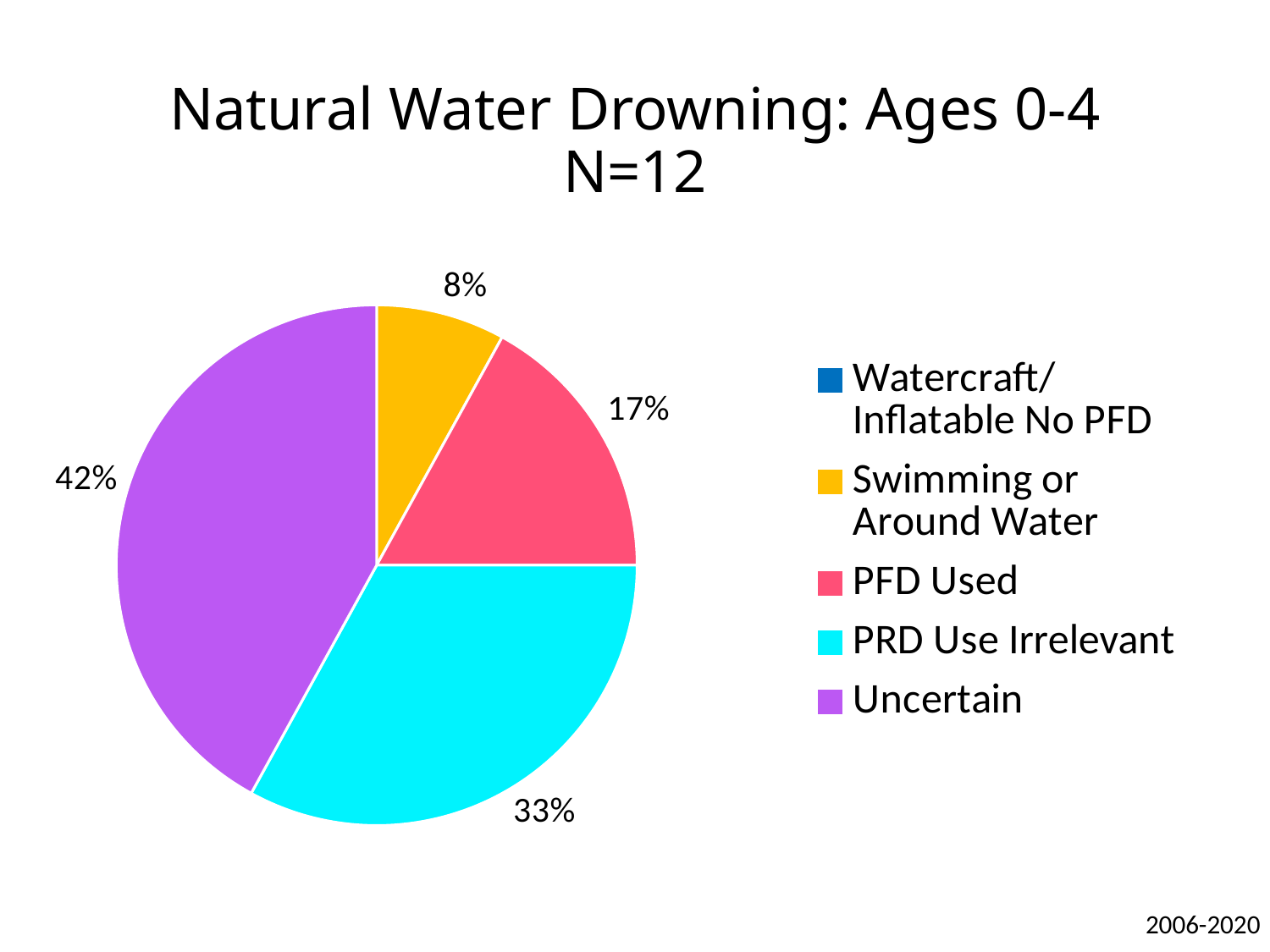
Which is larger, the PFD Used slice or the Swimming or Around Water slice? PFD Used What colour is the Uncertain slice? purple Which category has the largest slice of the pie? Uncertain What share of the pie does the PFD Used slice represent? 17% What share of the pie does the Uncertain slice represent? 42% What share of the pie does the Swimming or Around Water slice represent? 8% Which labelled slice of the pie is the smallest? Swimming or Around Water How many entries does the legend list? 5 What kind of chart is shown on the slide? pie chart What is the difference in percentage points between the Uncertain slice and the PRD Use Irrelevant slice? 9 What is the title of the chart? Natural Water Drowning: Ages 0-4 N=12